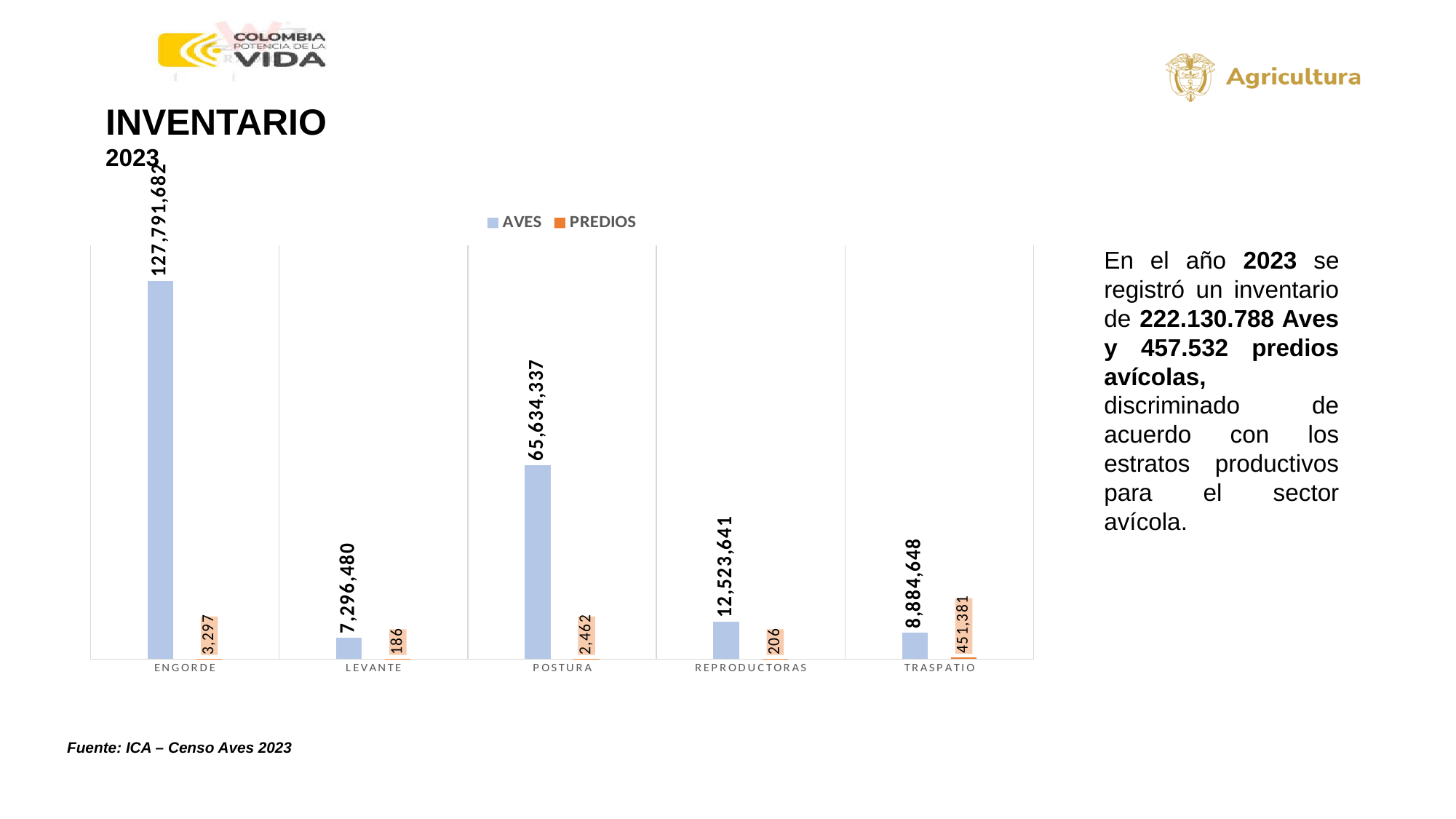
What is the AVES value for ENGORDE? 127,791,682 How many series does the legend list? 2 Which category has the lowest AVES value? LEVANTE Which category has the highest PREDIOS value? TRASPATIO What is the PREDIOS value for TRASPATIO? 451,381 What is the difference between the PREDIOS values for ENGORDE and POSTURA? 835 How many categories are shown on the x axis? 5 What is the difference between the AVES values for ENGORDE and POSTURA? 62,157,345 What is the AVES value for POSTURA? 65,634,337 What is the PREDIOS value for LEVANTE? 186 Which category has the highest AVES value? ENGORDE Which has the larger AVES value, REPRODUCTORAS or TRASPATIO? REPRODUCTORAS